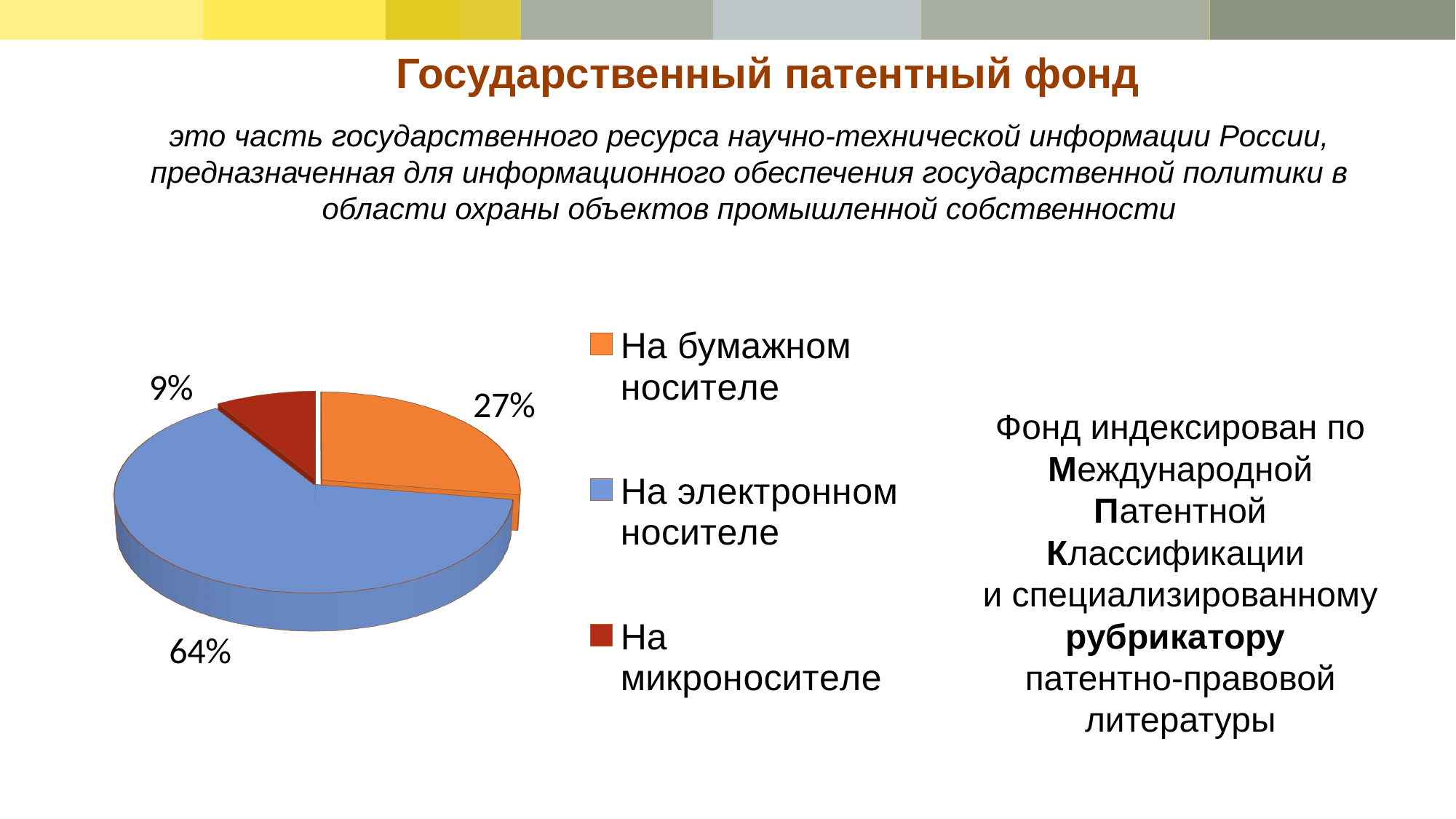
What kind of chart is shown on the slide? pie chart What colour is the slice for "На микроносителе"? dark red How many entries does the legend list? 3 Which is larger, the share for "На бумажном носителе" or the share for "На микроносителе"? На бумажном носителе Which category has the smallest slice of the pie? На микроносителе What share of the pie is labelled "На бумажном носителе"? 27% What share of the pie is labelled "На электронном носителе"? 64% What colour is the slice for "На электронном носителе"? blue How many slices does the pie chart have? 3 What share of the pie is labelled "На микроносителе"? 9% What is the difference in percentage points between "На электронном носителе" and "На бумажном носителе"? 37 Which category has the largest slice of the pie? На электронном носителе